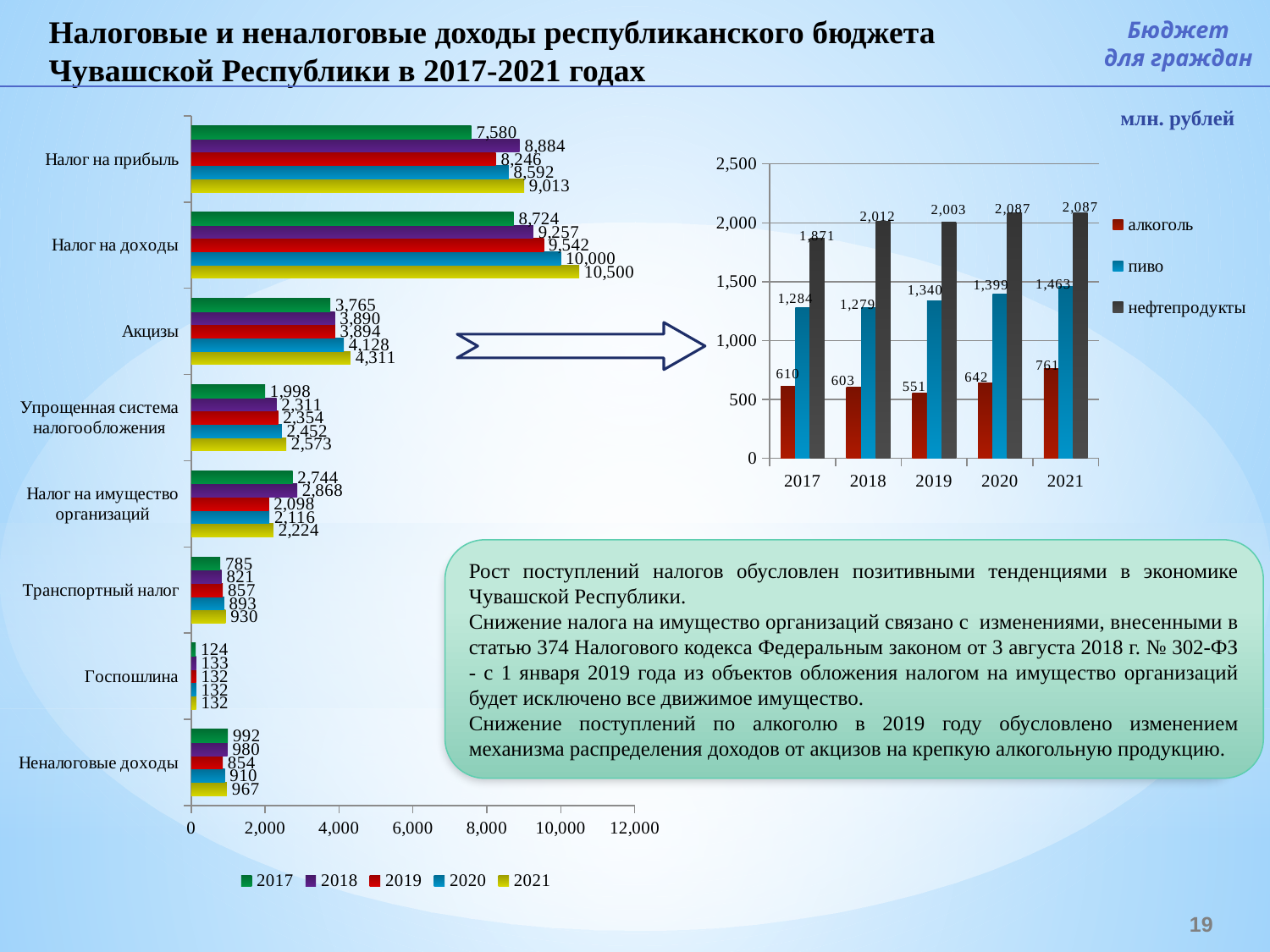
What kind of chart is the right chart? bar chart In the left chart, what is the value for Транспортный налог in 2019? 857 In the left chart, which category has the highest value in 2021? Налог на доходы In the left chart, what is the value for Налог на доходы in 2021? 10,500 In the left chart, what is the value for Налог на прибыль in 2017? 7,580 In the left chart, how many categories are shown on the vertical axis? 8 In the left chart, how many series does the legend list? 5 In the left chart, what is the difference between the 2021 and 2017 values for Акцизы? 546 In the right chart, is the value for пиво in 2021 larger or smaller than the value for алкоголь in 2021? larger In the left chart, which category has the lowest value in 2017? Госпошлина In the right chart, what is the value for нефтепродукты in 2019? 2,003 In the right chart, which year has the lowest value for алкоголь? 2019